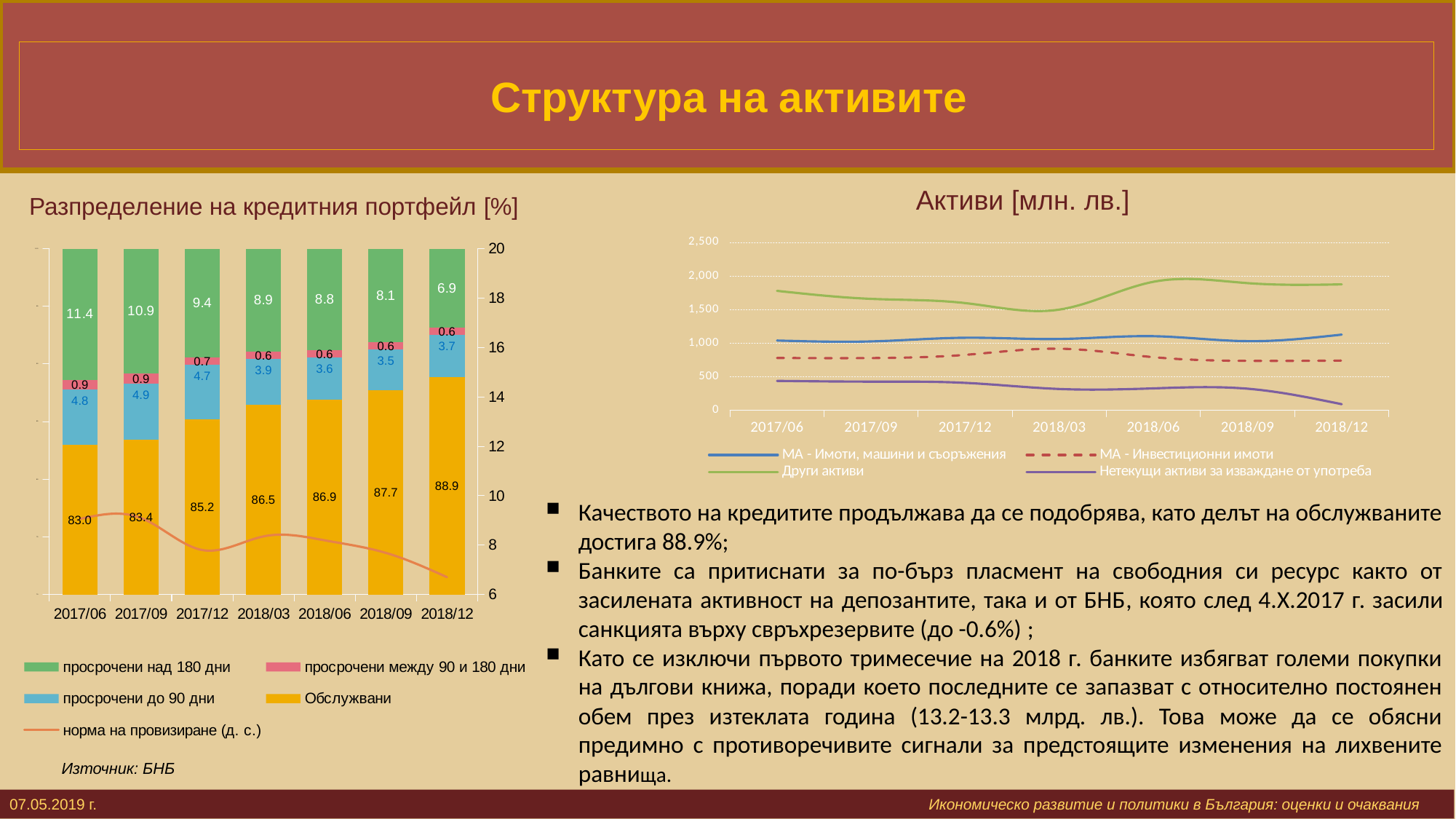
On the chart 'Разпределение на кредитния портфейл [%]', what is the value for 'Обслужвани' in 2018/12? 88.9 On the chart 'Разпределение на кредитния портфейл [%]', how many series does the legend list? 5 On the chart 'Активи [млн. лв.]', which series has the highest values across all periods? Други активи On the chart 'Разпределение на кредитния портфейл [%]', what is the value for 'просрочени до 90 дни' in 2018/03? 3.9 On the chart 'Активи [млн. лв.]', is the value for 'Други активи' in 2018/06 greater or less than 1,500? greater On the chart 'Разпределение на кредитния портфейл [%]', in which period is the value for 'просрочени над 180 дни' lowest? 2018/12 On the chart 'Разпределение на кредитния портфейл [%]', what is the difference between the 'Обслужвани' values in 2018/12 and 2017/06? 5.9 On the chart 'Разпределение на кредитния портфейл [%]', does the value for 'просрочени над 180 дни' rise or fall from 2017/06 to 2018/12? fall On the chart 'Разпределение на кредитния портфейл [%]', in which period is the value for 'Обслужвани' highest? 2018/12 On the chart 'Активи [млн. лв.]', what kind of chart is it? line chart On the chart 'Разпределение на кредитния портфейл [%]', what is the value for 'просрочени над 180 дни' in 2017/06? 11.4 On the chart 'Разпределение на кредитния портфейл [%]', how many periods are shown on the x axis? 7